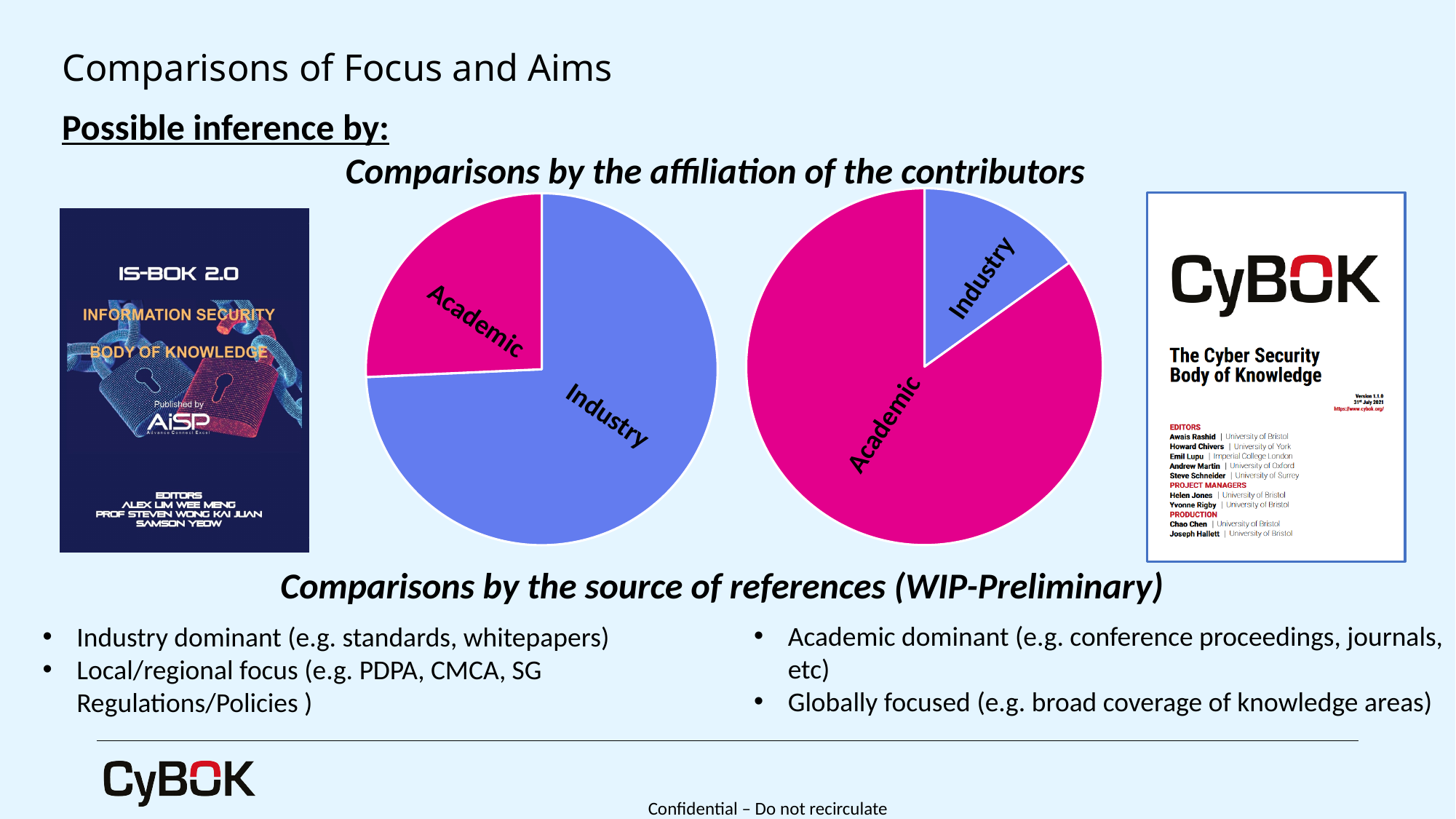
In the left pie chart, which slice is the largest? Industry How many slices does the left pie chart have? 2 In the left pie chart, which slice is the smallest? Academic How many slices does the right pie chart have? 2 What kind of chart is the left chart on the slide? Pie chart What kind of chart is the right chart on the slide? Pie chart In the right pie chart, is the Industry slice larger or smaller than the Academic slice? Smaller In the right pie chart, which slice is the smallest? Industry What colour is the Academic slice in the pie charts? Magenta (pink) In the right pie chart, which slice is the largest? Academic What are the two slice labels used in both pie charts? Academic and Industry In the left pie chart, is the Industry slice larger or smaller than the Academic slice? Larger